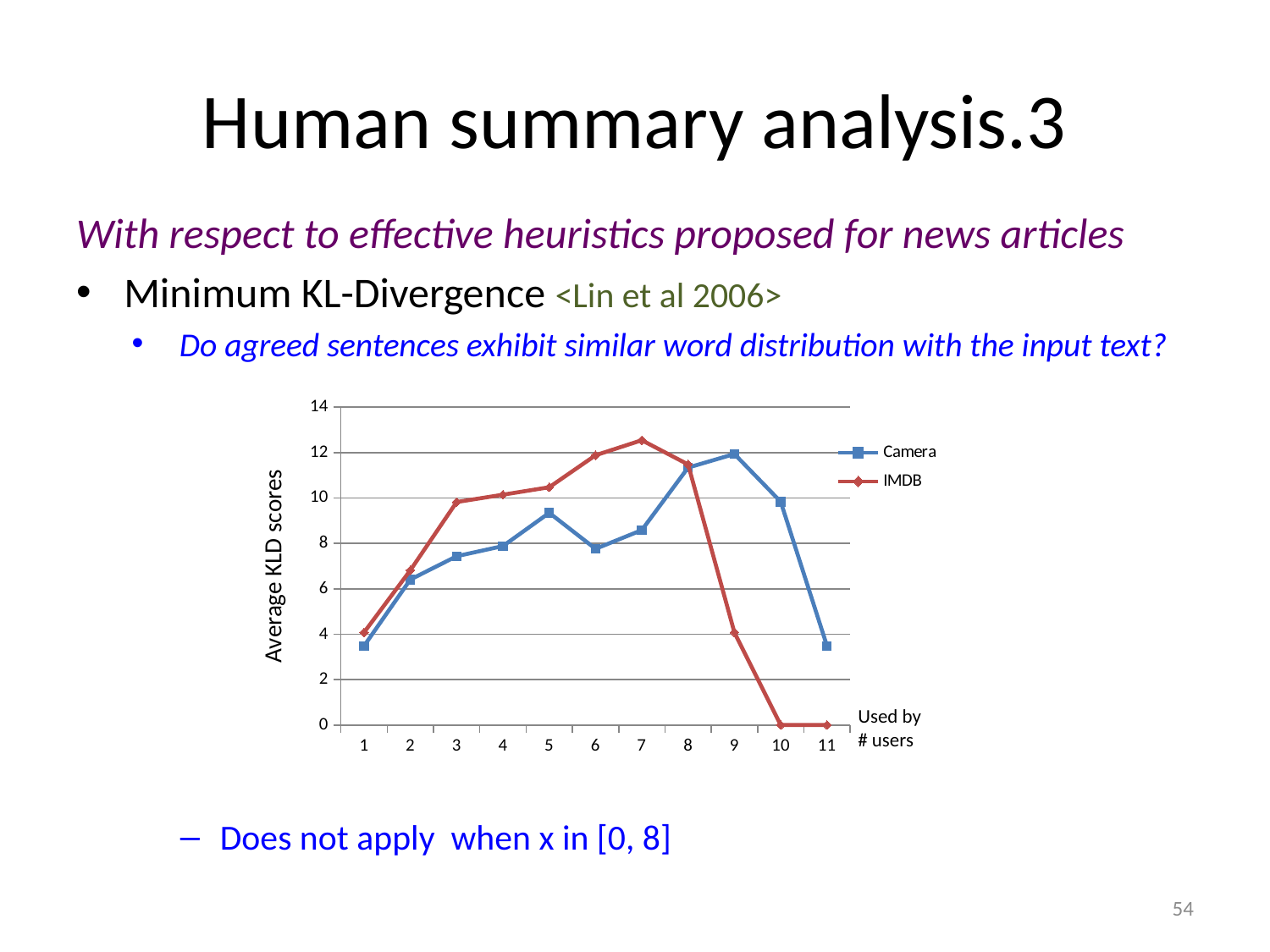
What is the IMDB value at x = 10? 0 Is the IMDB value at x = 9 greater or less than 6? less Does the IMDB series rise or fall from x = 8 to x = 10? fall What kind of chart is shown on the slide? line chart At which x value does the IMDB series reach its highest point? 7 Is the Camera value at x = 1 greater or less than 4? less How many series does the legend list? 2 At x = 10, which series has the higher value, Camera or IMDB? Camera Is the Camera value at x = 9 greater or less than 10? greater How many points along the x axis does each series have? 11 At x = 7, which series has the higher value, Camera or IMDB? IMDB